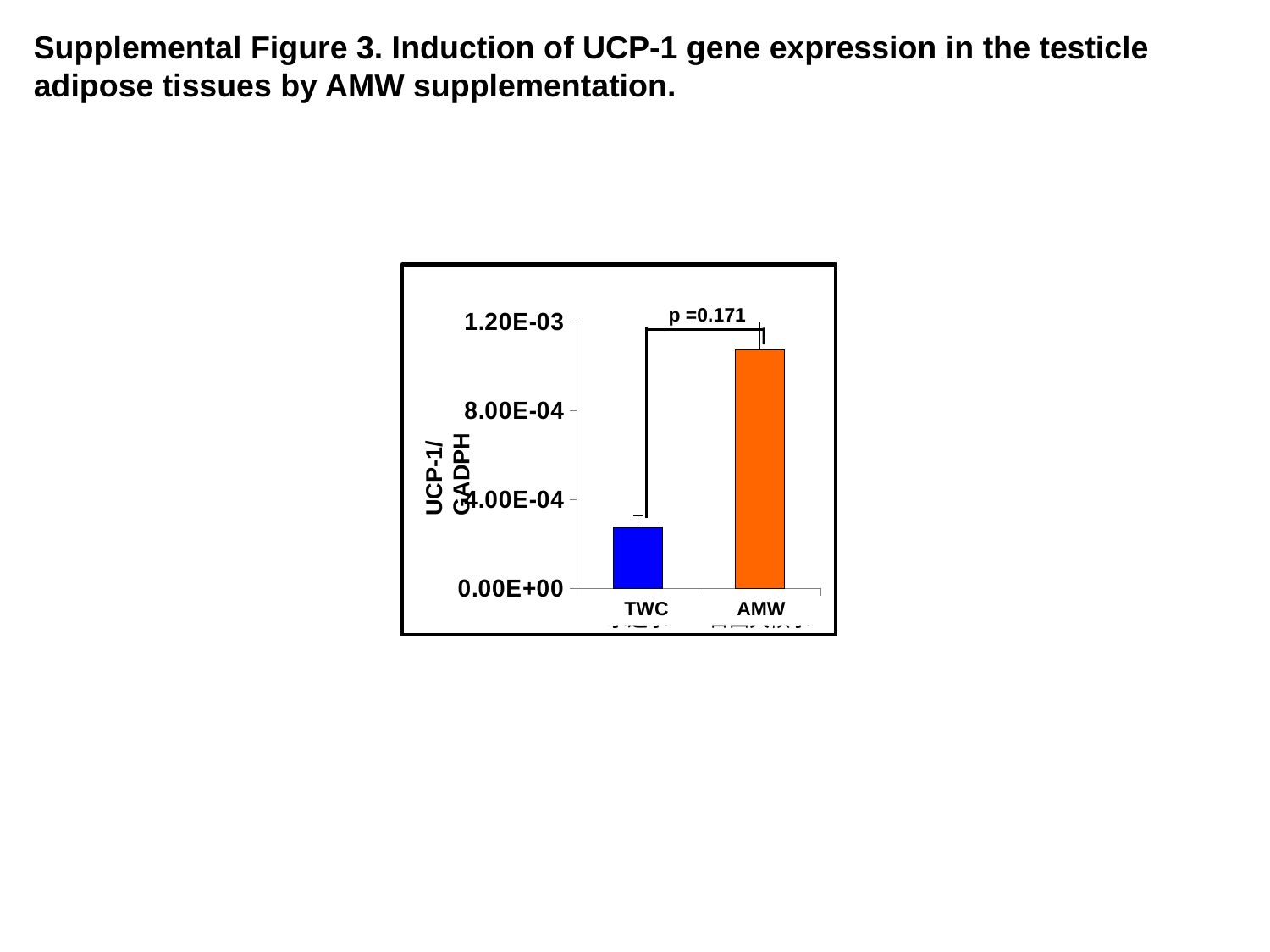
What is the label of the y axis? UCP-1/GADPH Which category has the lowest bar? TWC Is the value for AMW greater or less than 8.00E-04? greater Which bar is taller, TWC or AMW? AMW What p value is printed above the bars? p =0.171 How many categories are plotted on the x axis? 2 Which category has the highest bar? AMW What is the highest tick value shown on the y axis? 1.20E-03 Is the value for AMW greater or less than 1.20E-03? less Is the value for TWC greater or less than 4.00E-04? less What kind of chart is shown on the slide? bar chart